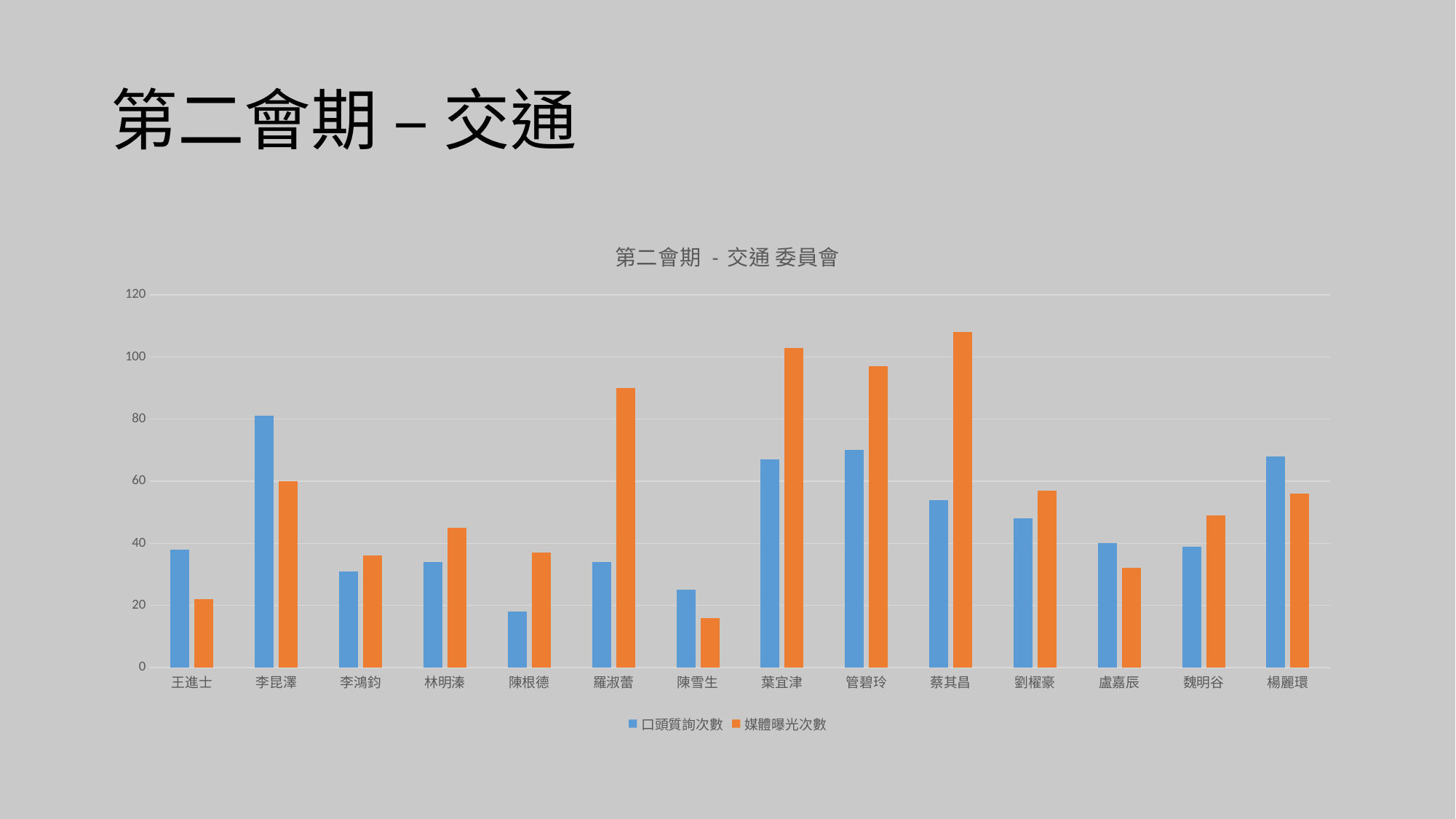
What kind of chart is shown on the slide? bar chart Which legislator has the lowest 媒體曝光次數? 陳雪生 How many series does the legend list? 2 How many legislators (categories) are shown on the x axis? 14 Which legislator has the lowest 口頭質詢次數? 陳根德 Which legislator has the highest 媒體曝光次數? 蔡其昌 Is the 口頭質詢次數 value for 李昆澤 greater or less than 60? greater Which legislator has the highest 口頭質詢次數? 李昆澤 Is the 媒體曝光次數 value for 羅淑蕾 greater or less than 80? greater What is the title of the chart? 第二會期 - 交通 委員會 Is the 媒體曝光次數 value for 陳雪生 greater or less than 20? less For 李昆澤, which is larger: 口頭質詢次數 or 媒體曝光次數? 口頭質詢次數